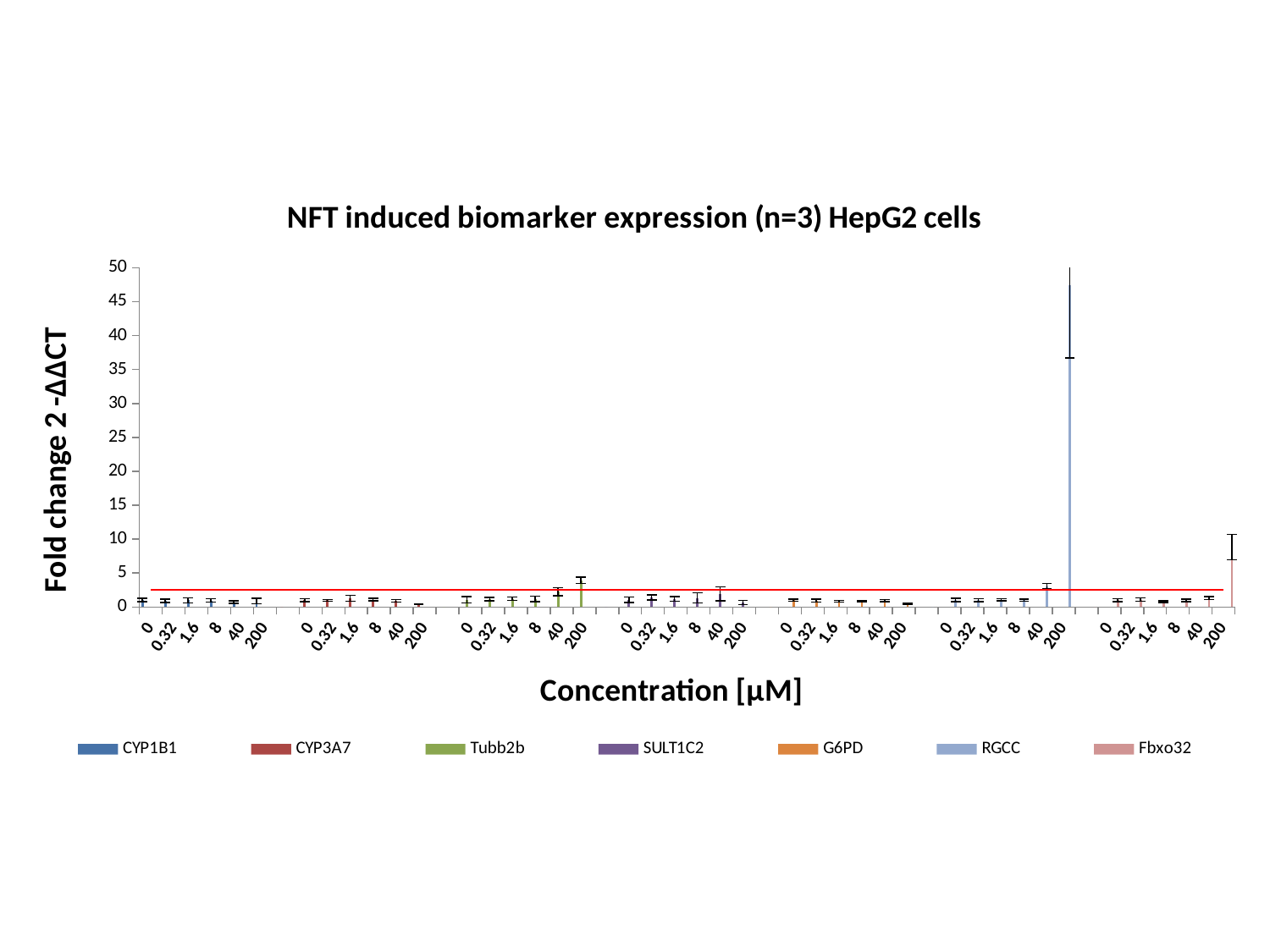
Which series has the highest bar on the chart? RGCC What kind of chart is shown on the slide? bar chart Is the value for RGCC at 200 µM greater or less than 40? greater Is the value for RGCC at 200 µM greater or less than 30? greater What is the label of the x axis? Concentration [µM] Is the value for Fbxo32 at 200 µM greater or less than 5? greater What is the title of the chart? NFT induced biomarker expression (n=3) HepG2 cells At which concentration does RGCC reach its highest value? 200 Which is larger: RGCC at 200 µM or Fbxo32 at 200 µM? RGCC at 200 µM How many concentration levels are plotted for each series? 6 How many series does the legend list? 7